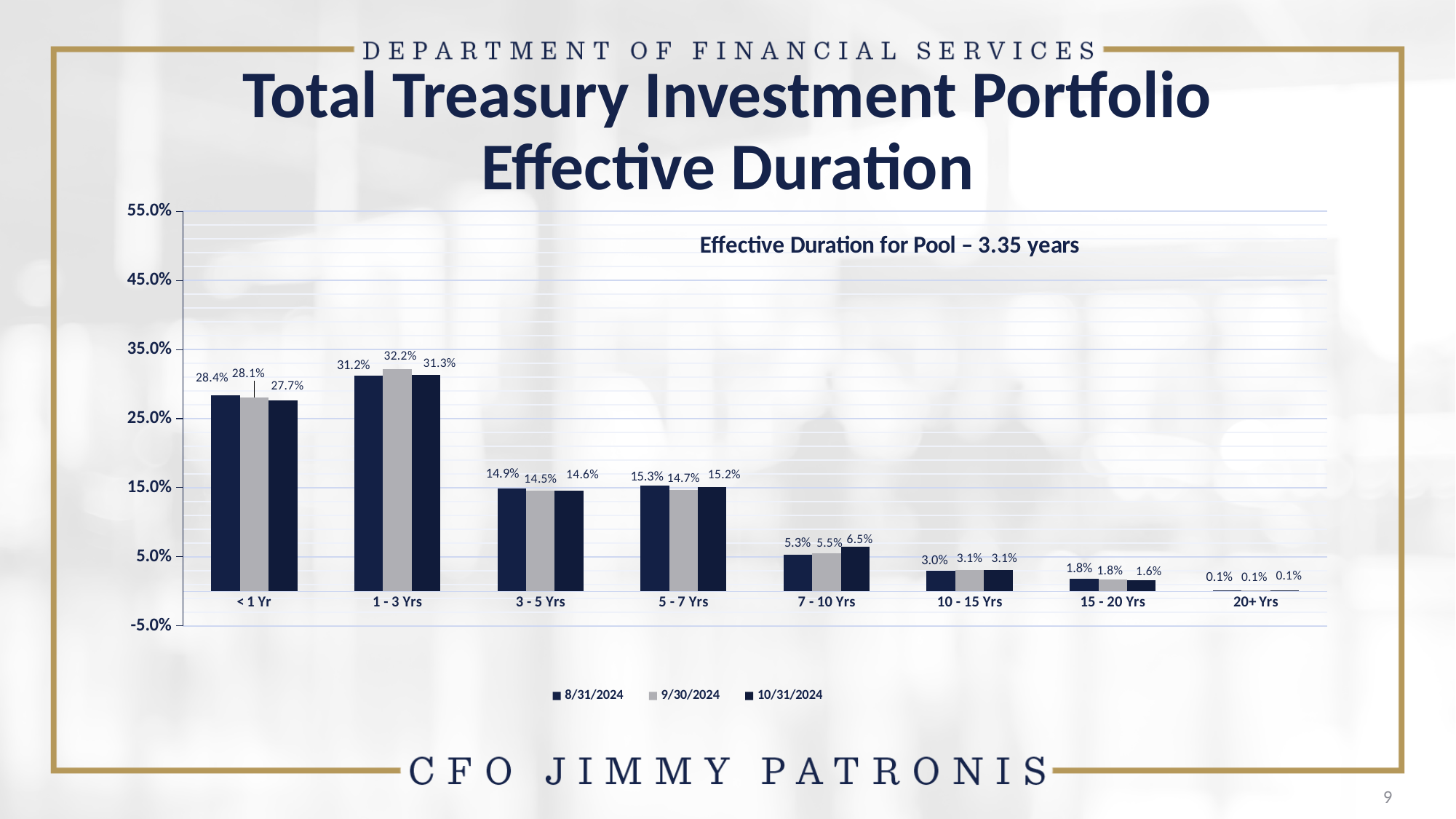
What is the value for the 1 - 3 Yrs category in the 9/30/2024 series? 32.2% How many maturity categories are shown on the x axis? 8 How many series does the legend list? 3 Which category has the highest value in the 10/31/2024 series? 1 - 3 Yrs What is the difference between the 9/30/2024 and 8/31/2024 values for the 1 - 3 Yrs category? 1.0% What is the value for the 7 - 10 Yrs category in the 8/31/2024 series? 5.3% Which is larger for the 7 - 10 Yrs category: the 8/31/2024 value or the 10/31/2024 value? 10/31/2024 Which category has the lowest value in the 8/31/2024 series? 20+ Yrs Do the 10/31/2024 values generally rise or fall from the 1 - 3 Yrs category to the 20+ Yrs category? fall What kind of chart is shown on the slide? bar chart What effective duration for the pool is stated on the chart? 3.35 years What is the value for the < 1 Yr category in the 10/31/2024 series? 27.7%